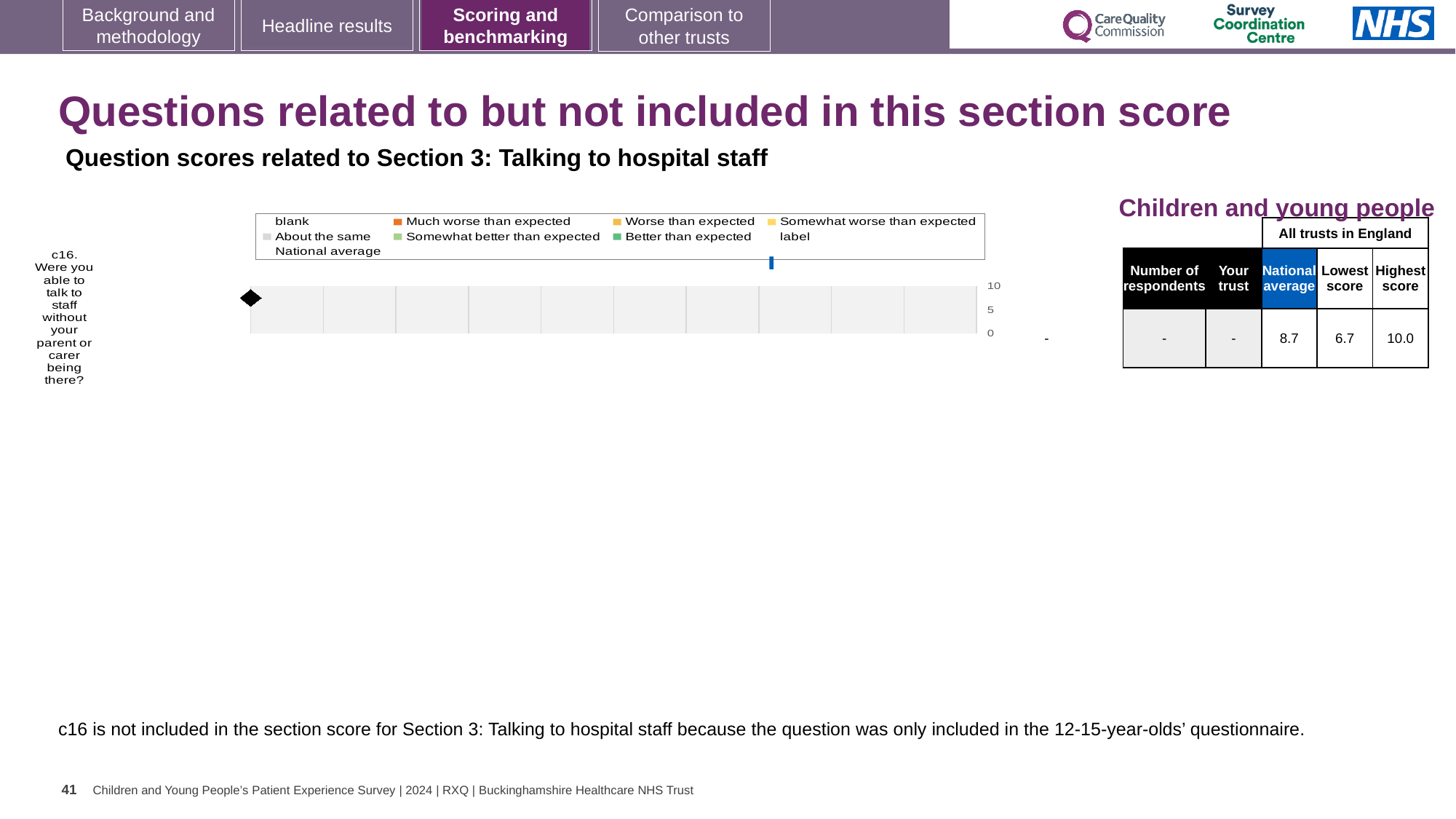
What kind of chart is shown on the slide? bar chart What is the lowest score across all trusts in England for c16 shown in the table? 6.7 What is the highest score across all trusts in England for c16 shown in the table? 10.0 What is the highest value shown on the chart's axis? 10 Which question is shown as the category on the chart? c16 What is the difference between the highest score and the lowest score for c16 in the table? 3.3 How many survey questions (categories) are plotted on the chart? 1 What value is shown for 'Your trust' for c16 in the table? - What is the national average score for c16 shown in the table? 8.7